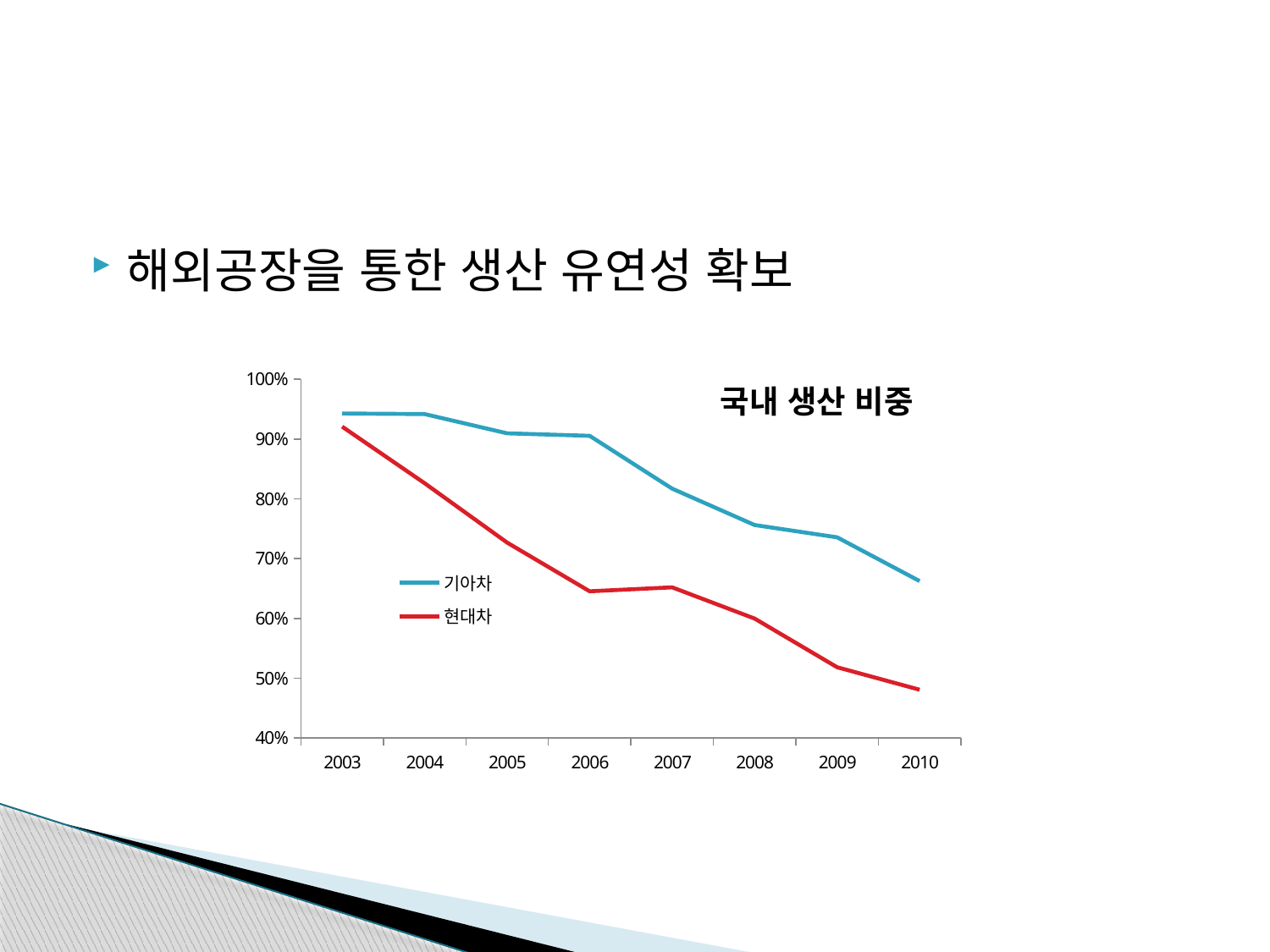
Do the values for 기아차 rise or fall from 2003 to 2010? fall How many series does the legend list? 2 Which series is drawn in red? 현대차 What is the title of the chart? 국내 생산 비중 Is the value for 기아차 in 2010 greater or less than 60%? greater In 2007, which series has the higher value, 기아차 or 현대차? 기아차 What kind of chart is shown on the slide? line chart Do the values for 현대차 rise or fall from 2003 to 2010? fall How many years are shown on the x axis? 8 In which year is the value for 현대차 lowest? 2010 Is the value for 현대차 in 2003 greater or less than 90%? greater Is the value for 현대차 in 2010 greater or less than 50%? less